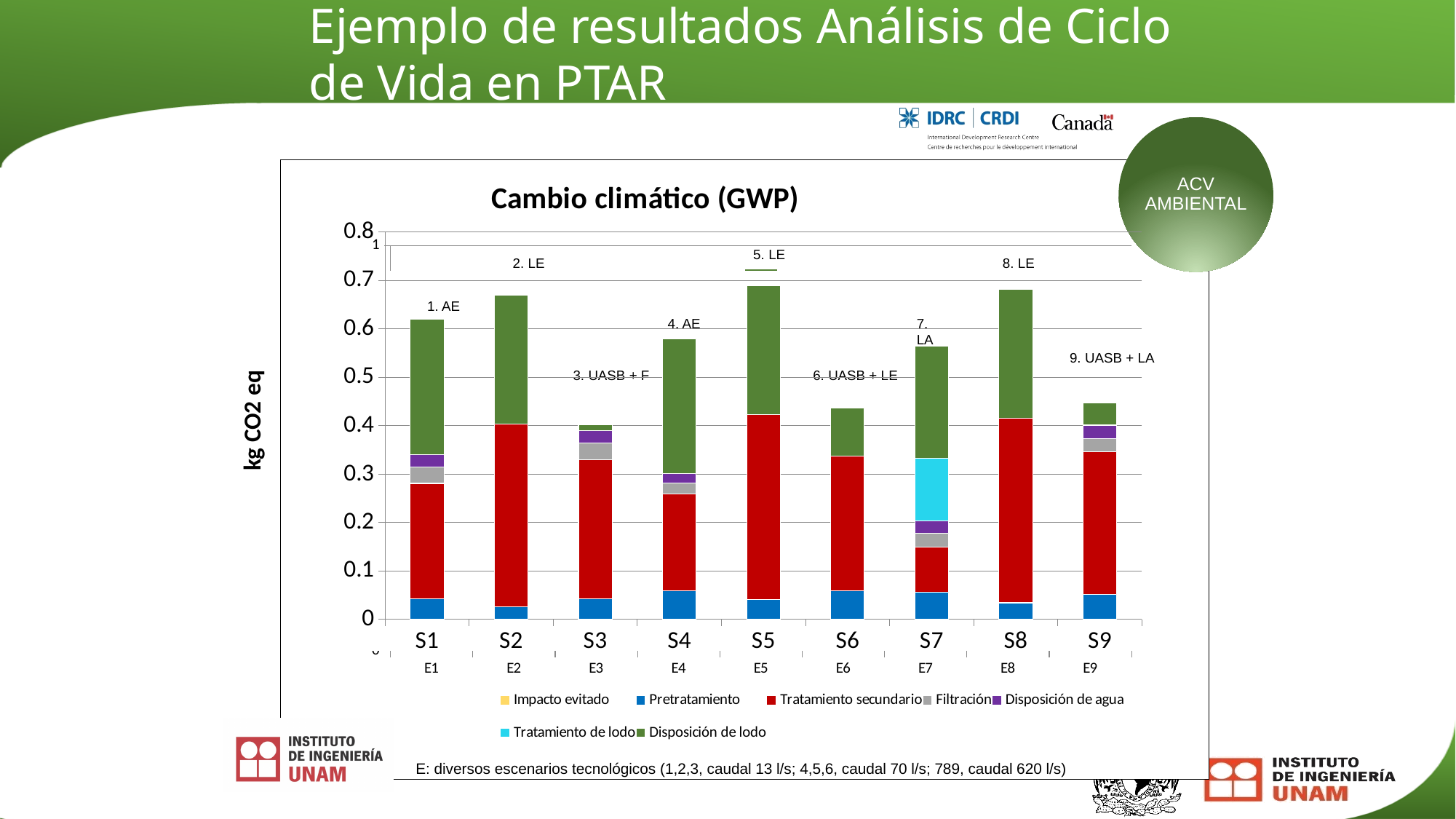
Is the total value for S7 greater or less than 0.5? greater What is the label of the vertical axis? kg CO2 eq How many series does the chart legend list? 7 Is the total value for S2 greater or less than 0.6? greater What kind of chart is shown on the slide? Stacked bar chart How many scenario categories (S1–S9) are plotted on the x axis? 9 Which has the larger total bar, S2 or S3? S2 Is the total value for S3 greater or less than 0.5? less What is the title of the chart? Cambio climático (GWP) Which scenario has the lowest total stacked bar? S3 Which has the larger total bar, S4 or S6? S4